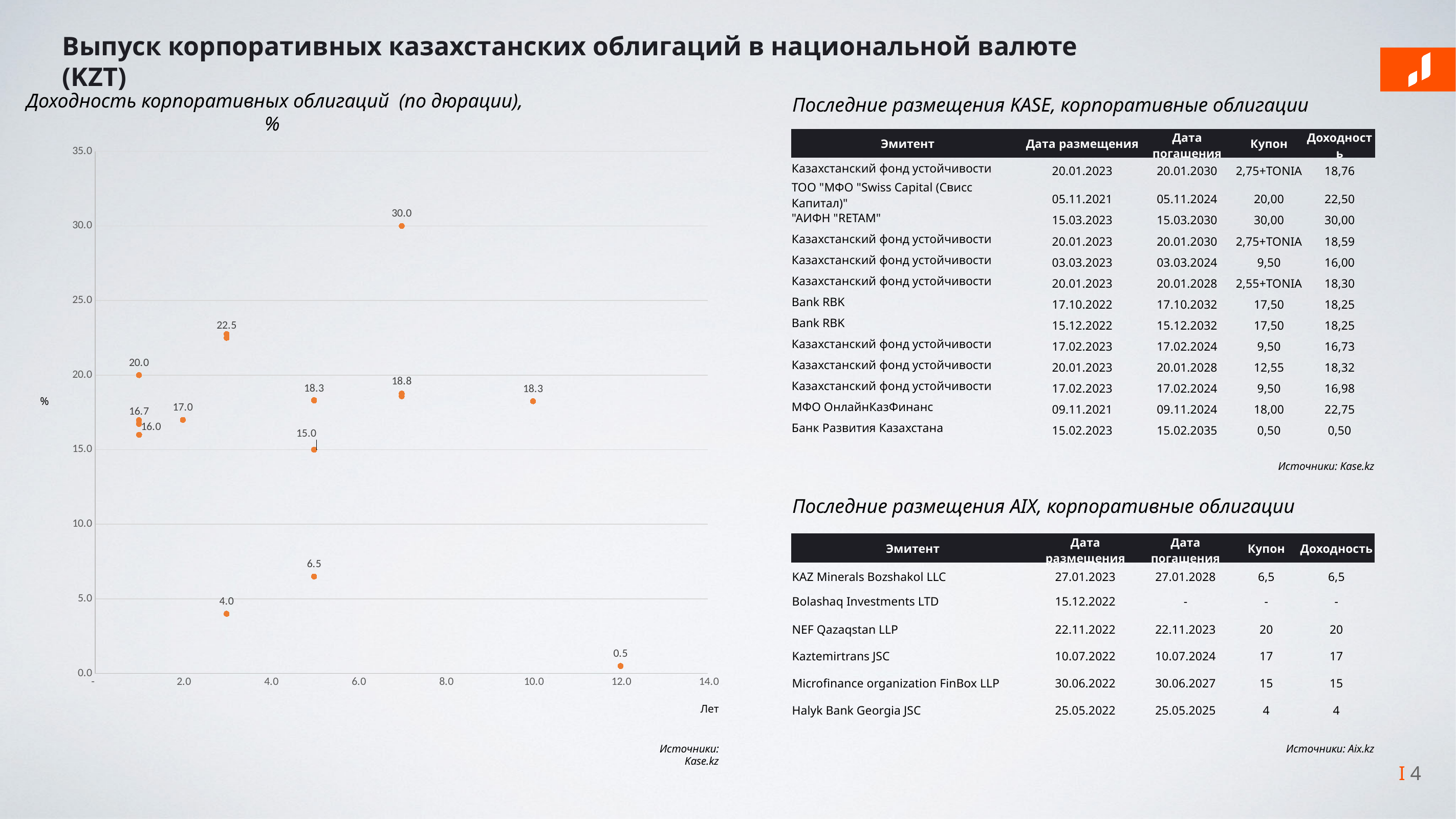
What is the label of the x axis of the chart? Лет Is the value of the point at 12.0 years greater or less than 5.0? less What is the lowest yield value labelled on the chart? 0.5 What is the yield value of the point at 12.0 years on the chart? 0.5 What kind of chart is shown on the slide? scatter chart What is the difference between the points labelled 22.5 and 4.0 on the chart? 18.5 Which is larger on the chart: the point labelled 30.0 or the point labelled 22.5? 30.0 What is the yield value of the point at 10.0 years on the chart? 18.3 What is the difference between the highest labelled value (30.0) and the lowest labelled value (0.5) on the chart? 29.5 What is the yield value of the point at 2.0 years on the chart? 17.0 What is the title of the chart? Доходность корпоративных облигаций (по дюрации), % What is the highest yield value labelled on the chart? 30.0